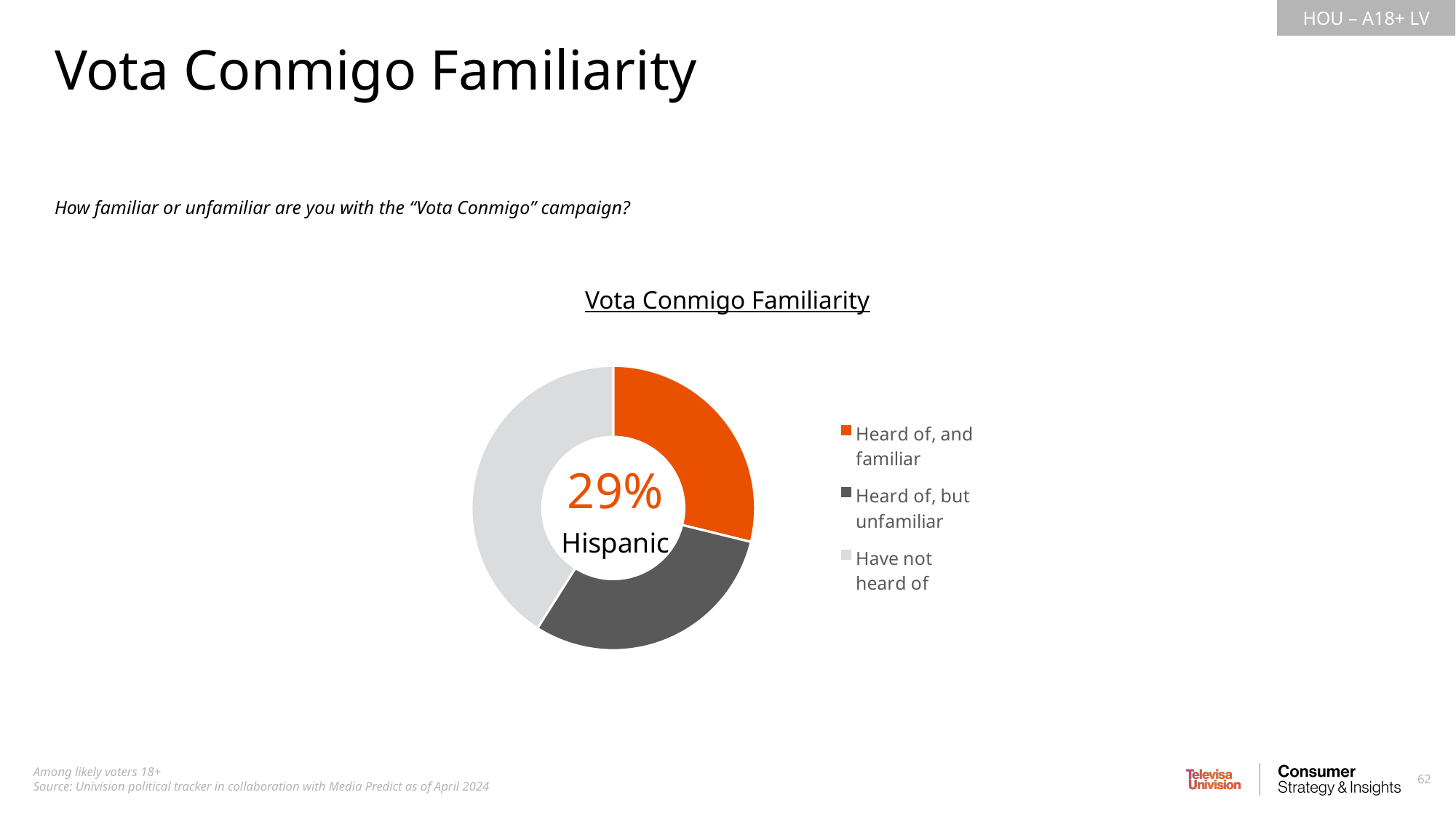
Which category takes up the largest slice of the donut chart? Have not heard of Which group does the donut chart describe, according to the label in its centre? Hispanic How many slices does the donut chart have? 3 Which legend category is shown in orange? Heard of, and familiar How many entries does the legend list? 3 What is the title of the chart? Vota Conmigo Familiarity What percentage is printed in the centre of the donut chart? 29% Which slice is larger: "Have not heard of" or "Heard of, and familiar"? Have not heard of What share of Hispanic likely voters have heard of, and are familiar with, the Vota Conmigo campaign? 29% What kind of chart is shown on the slide? Pie (donut) chart